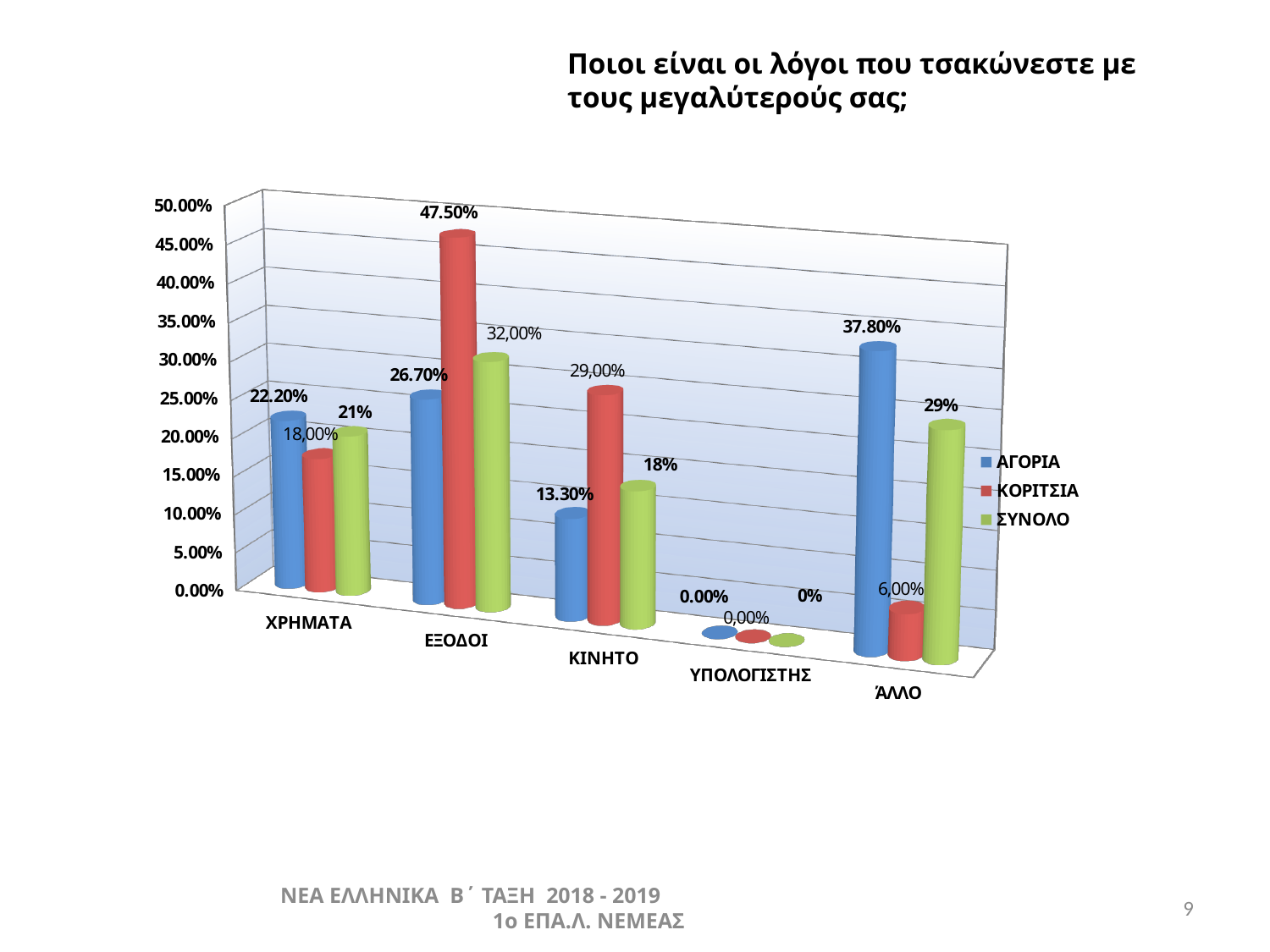
Which category has the lowest value for ΣΥΝΟΛΟ? ΥΠΟΛΟΓΙΣΤΗΣ What is the value for ΚΟΡΙΤΣΙΑ in the ΚΙΝΗΤΟ category? 29,00% What kind of chart is shown on the slide? Bar chart What is the difference between the ΚΟΡΙΤΣΙΑ and ΑΓΟΡΙΑ values in the ΕΞΟΔΟΙ category? 20.80% How many series does the legend list? 3 What is the value for ΣΥΝΟΛΟ in the ΆΛΛΟ category? 29% What is the value for ΑΓΟΡΙΑ in the ΧΡΗΜΑΤΑ category? 22.20% What is the value for ΚΟΡΙΤΣΙΑ in the ΕΞΟΔΟΙ category? 47.50% Which category has the highest value for ΑΓΟΡΙΑ? ΆΛΛΟ Which colour represents the ΣΥΝΟΛΟ series? Green In the ΆΛΛΟ category, which is larger: the value for ΑΓΟΡΙΑ or for ΚΟΡΙΤΣΙΑ? ΑΓΟΡΙΑ How many categories are shown on the x axis? 5